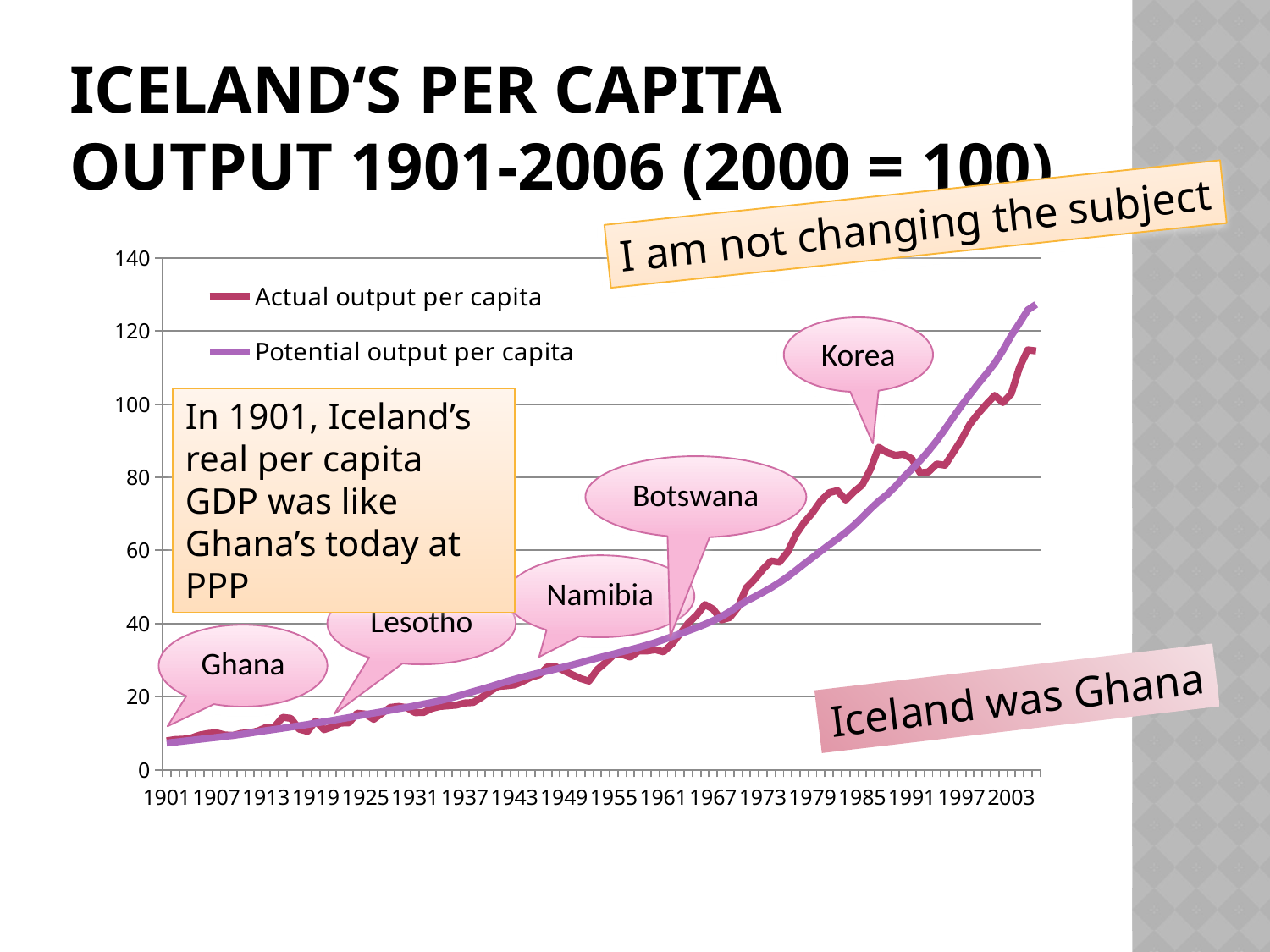
What kind of chart is shown on the slide? Line chart What is the highest value shown on the vertical axis of the chart? 140 Around 1985, which series has the higher value: Actual output per capita or Potential output per capita? Actual output per capita At the end of the period (2006), which series has the higher value: Actual output per capita or Potential output per capita? Potential output per capita How many series does the chart's legend list? 2 Is the peak value of Actual output per capita around 1985 greater or less than 100? less What is the title of the chart on the slide? ICELAND'S PER CAPITA OUTPUT 1901-2006 (2000 = 100) Is the value of Potential output per capita at the end of the period (2006) greater or less than 120? greater Is the value of Actual output per capita around 1979 greater or less than 60? greater What are the two series named in the legend? Actual output per capita and Potential output per capita Overall, do the values of Actual output per capita rise or fall from 1901 to 2006? Rise